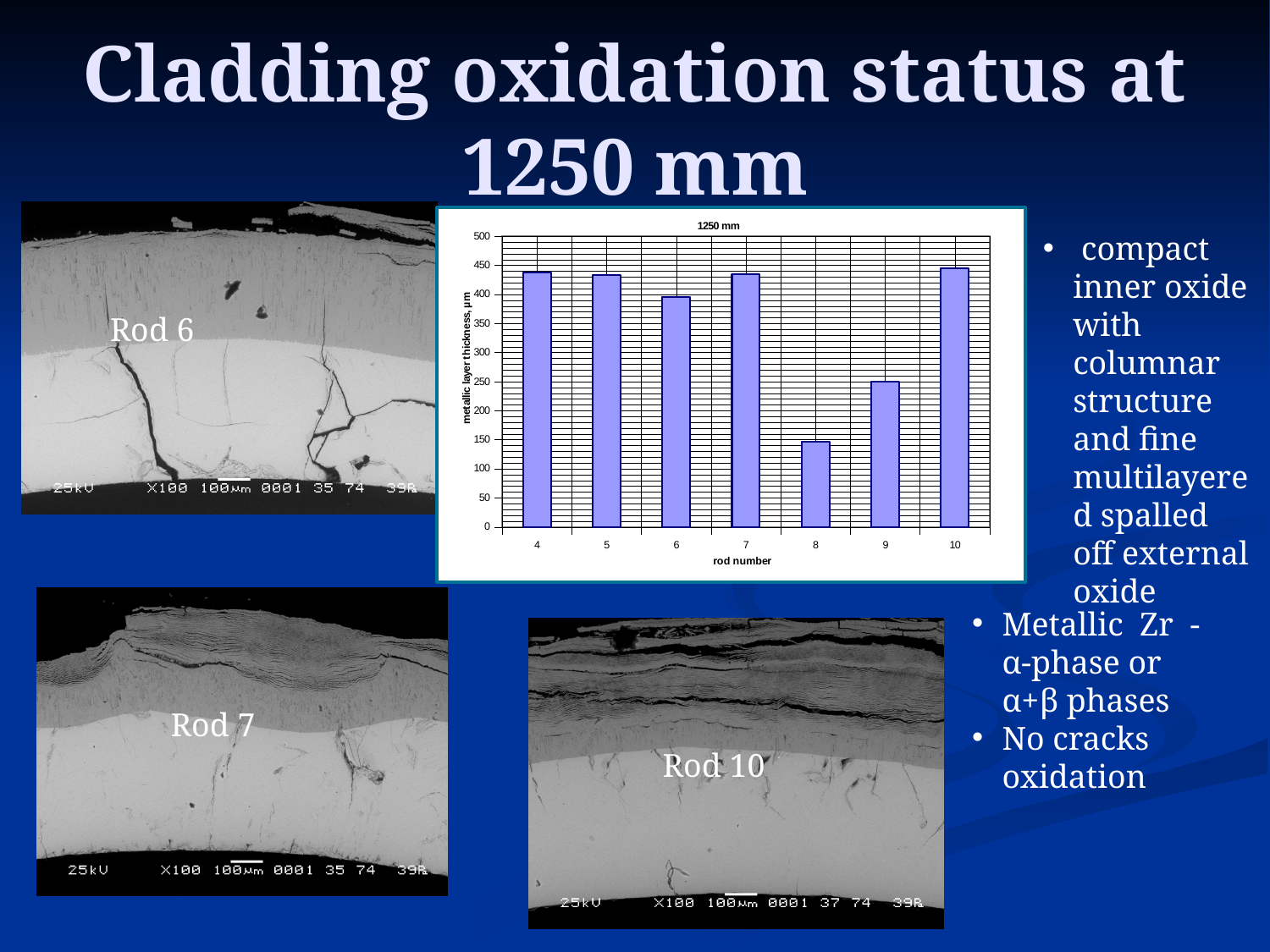
Is the metallic layer thickness for rod 8 greater or less than 200? less What kind of chart is shown on the slide? bar chart Is the metallic layer thickness for rod 9 greater or less than 300? less Which has a larger metallic layer thickness, rod 8 or rod 9? rod 9 Is the metallic layer thickness for rod 9 greater or less than 200? greater What is the label of the chart's vertical axis? metallic layer thickness, µm Which rod number has the lowest metallic layer thickness? 8 Which has a larger metallic layer thickness, rod 6 or rod 7? rod 7 What is the title of the chart? 1250 mm How many rod numbers are plotted on the chart? 7